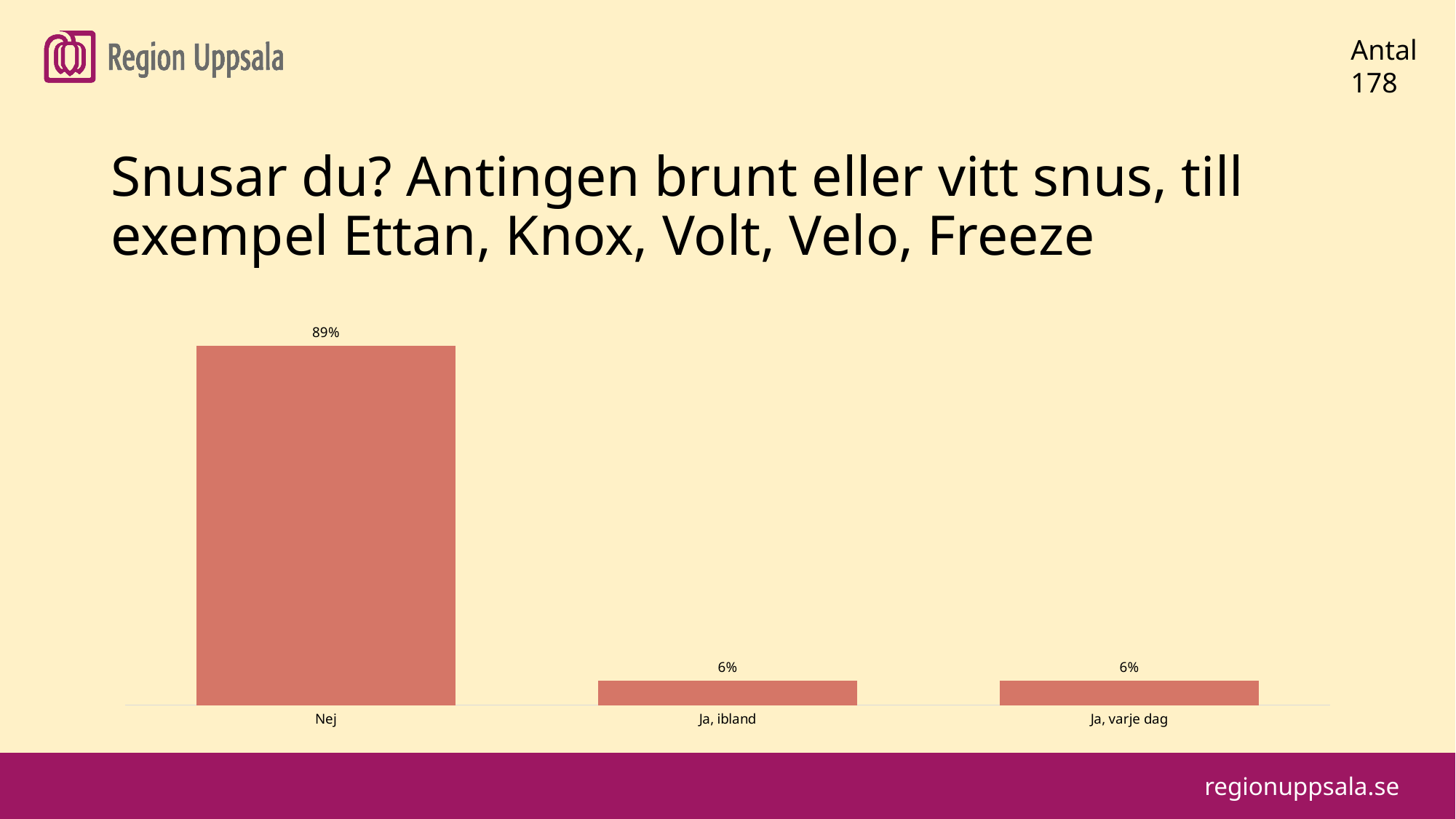
Which category has the highest value? Nej Do the values rise or fall from "Nej" to "Ja, ibland"? Fall What kind of chart is shown on the slide? Bar chart What is the total of the values for "Ja, ibland" and "Ja, varje dag"? 12% Which is larger, the value for "Nej" or the value for "Ja, varje dag"? Nej What is the difference between the values for "Nej" and "Ja, ibland"? 83% What is the value for "Nej"? 89% What is the title of the slide containing the chart? Snusar du? Antingen brunt eller vitt snus, till exempel Ettan, Knox, Volt, Velo, Freeze What number is shown under "Antal" in the top right corner of the slide? 178 How many categories are shown on the x axis? 3 What is the value for "Ja, varje dag"? 6% What is the value for "Ja, ibland"? 6%